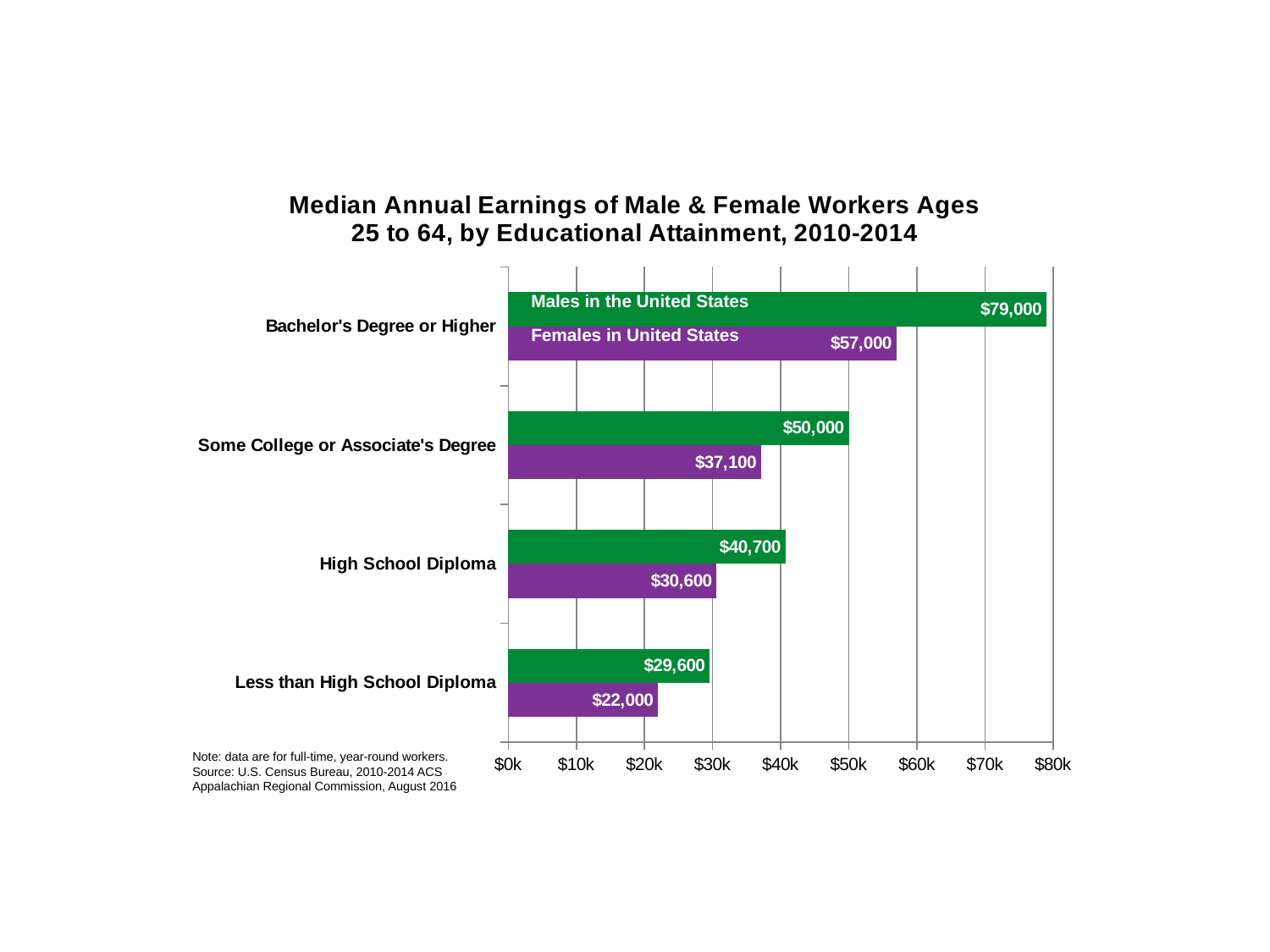
What is the difference between male and female median annual earnings for workers with a Bachelor's Degree or Higher? $22,000 Which educational attainment category has the highest median annual earnings for females in the United States? Bachelor's Degree or Higher What type of chart is shown on the slide? Bar chart What is the difference between male and female median annual earnings for workers with Less than High School Diploma? $7,600 What is the median annual earnings for females in the United States with Some College or Associate's Degree? $37,100 How many educational attainment categories are shown on the chart? 4 Which colour represents females in the United States on the chart? Purple Which is larger: median earnings for females with a Bachelor's Degree or Higher, or males with Some College or Associate's Degree? Females with a Bachelor's Degree or Higher How many series does the chart show? 2 What is the median annual earnings for males in the United States with a Bachelor's Degree or Higher? $79,000 What is the median annual earnings for females in the United States with a High School Diploma? $30,600 Which educational attainment category has the lowest median annual earnings for males in the United States? Less than High School Diploma